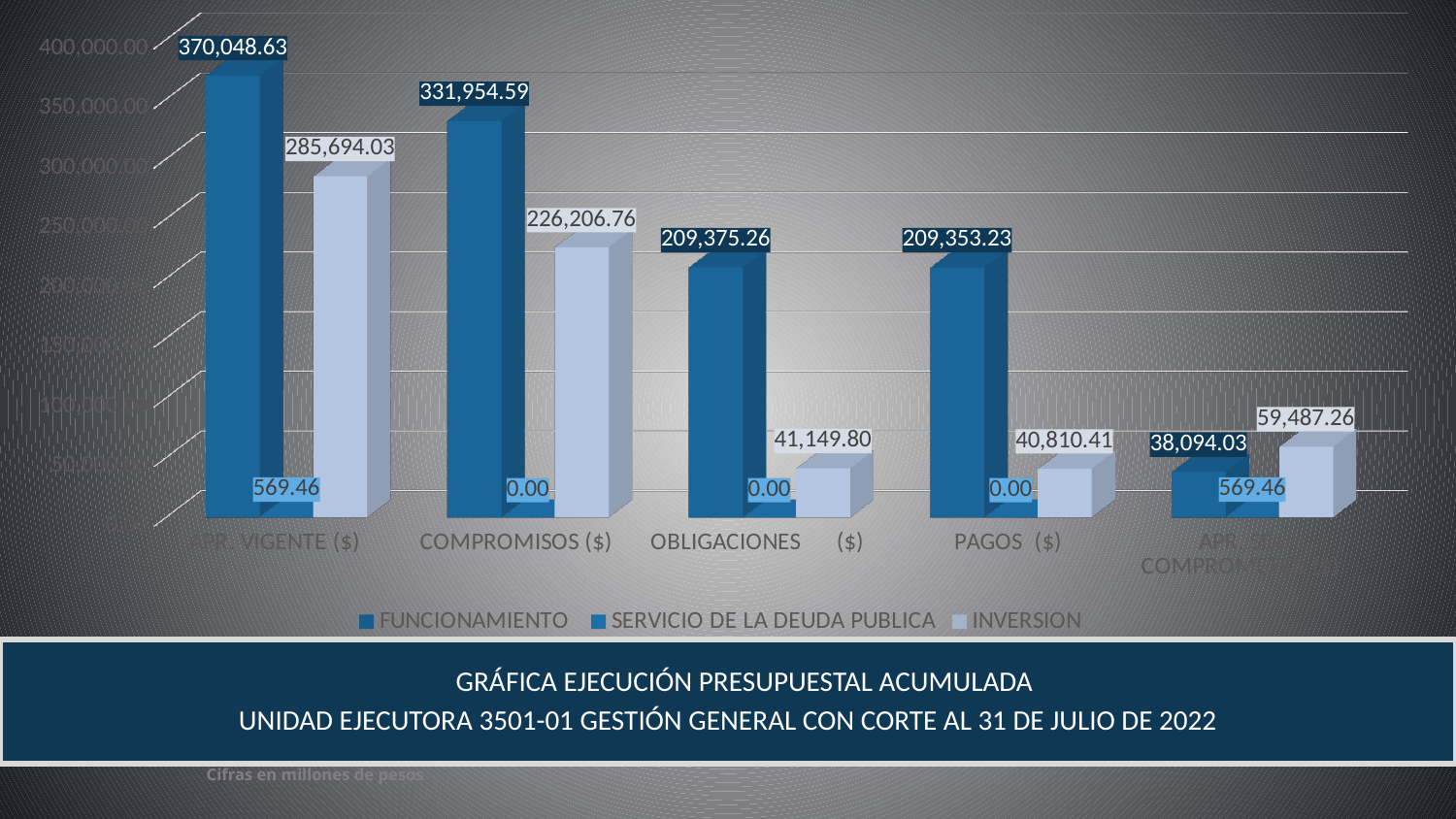
What kind of chart is shown on the slide? Bar chart Which category has the highest FUNCIONAMIENTO value? APR. VIGENTE ($) Is the FUNCIONAMIENTO value for COMPROMISOS ($) greater or less than 300,000.00? greater What is the value of FUNCIONAMIENTO for APR. VIGENTE ($)? 370,048.63 Which is larger for COMPROMISOS ($): FUNCIONAMIENTO or INVERSION? FUNCIONAMIENTO Does the FUNCIONAMIENTO value rise or fall from APR. VIGENTE ($) to PAGOS ($)? Fall How many series does the legend list? 3 What is the value of INVERSION for OBLIGACIONES ($)? 41,149.80 What is the value of SERVICIO DE LA DEUDA PUBLICA for PAGOS ($)? 0.00 What is the value of INVERSION for COMPROMISOS ($)? 226,206.76 Which category has the lowest INVERSION value? PAGOS ($) What is the difference between FUNCIONAMIENTO and INVERSION for APR. VIGENTE ($)? 84,354.60